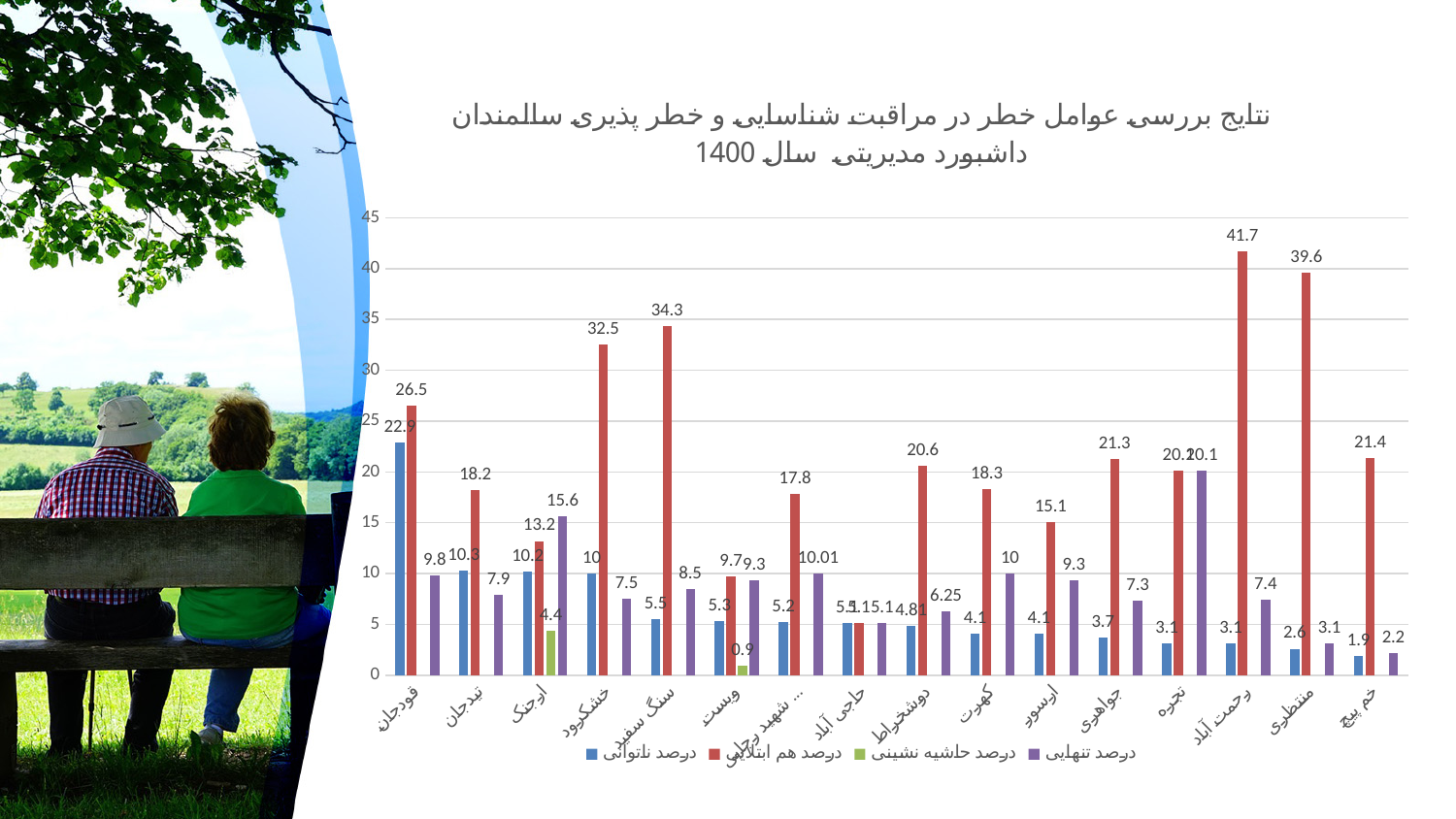
Which is larger: درصد هم ابتلایی for خشکرود or for سنگ سفید? سنگ سفید Which series is shown in red in the legend? درصد هم ابتلایی What is the value of درصد تنهایی for ارجنک? 15.6 How many series does the legend list? 4 What type of chart is shown on the slide? Bar chart What is the value of درصد ناتوانی for قودجان? 22.9 What is the difference between درصد هم ابتلایی for رحمت آباد and for منتظری? 2.1 Which category has the lowest value for درصد ناتوانی? خم پیچ What is the value of درصد هم ابتلایی for رحمت آباد? 41.7 Which category has the highest value for درصد هم ابتلایی? رحمت آباد How many categories are shown on the x axis? 16